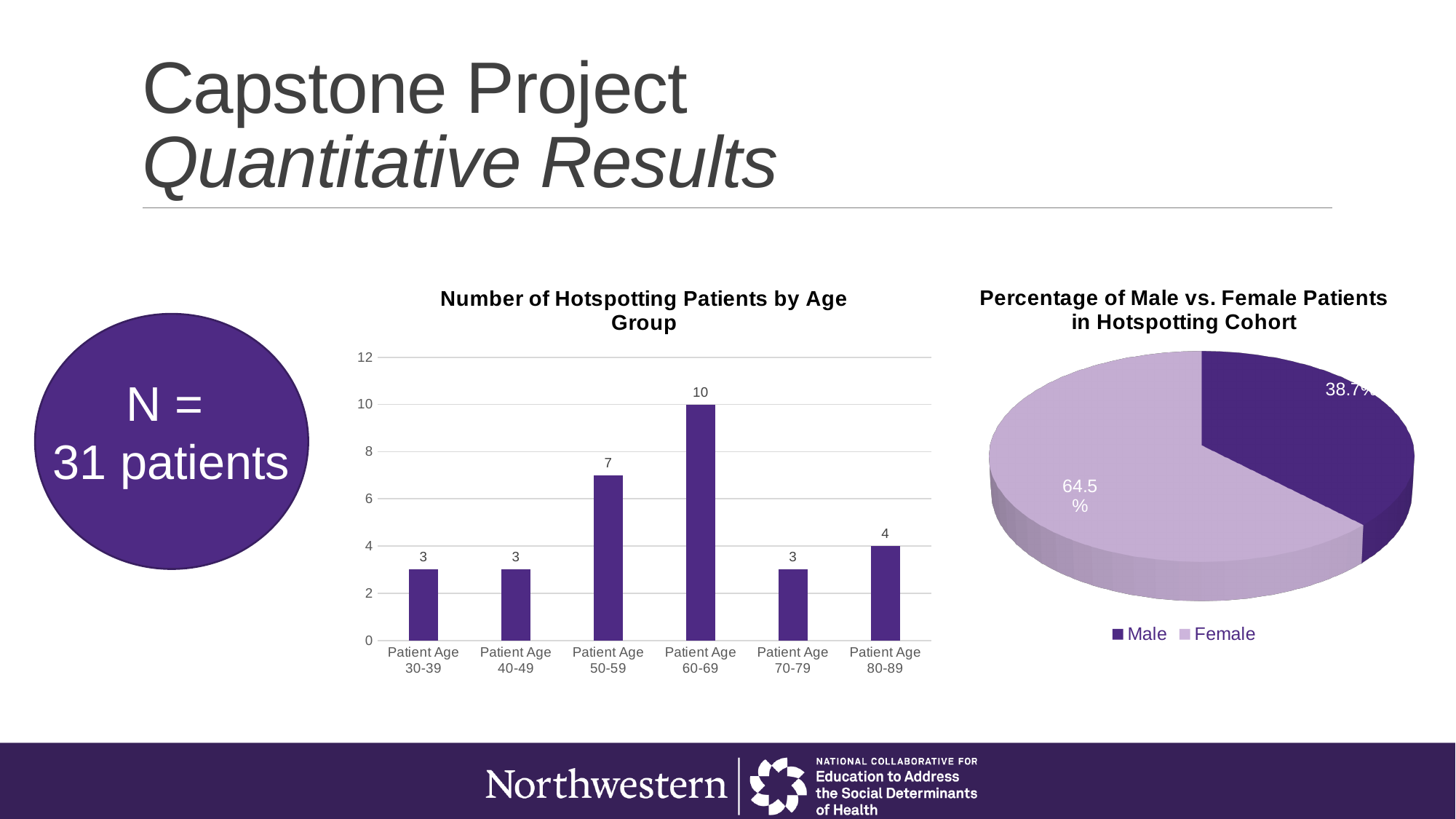
In the 'Percentage of Male vs. Female Patients in Hotspotting Cohort' chart, what share of patients are Female? 64.5% In the 'Number of Hotspotting Patients by Age Group' chart, how many patients are in the Patient Age 60-69 group? 10 In the 'Percentage of Male vs. Female Patients in Hotspotting Cohort' chart, what share of patients are Male? 38.7% What kind of chart is 'Number of Hotspotting Patients by Age Group'? Bar chart In the 'Number of Hotspotting Patients by Age Group' chart, which has more patients: Patient Age 80-89 or Patient Age 70-79? Patient Age 80-89 In the 'Number of Hotspotting Patients by Age Group' chart, how many patients are in the Patient Age 80-89 group? 4 In the 'Number of Hotspotting Patients by Age Group' chart, how many age groups are shown? 6 How many entries does the legend of the 'Percentage of Male vs. Female Patients in Hotspotting Cohort' chart list? 2 What kind of chart is 'Percentage of Male vs. Female Patients in Hotspotting Cohort'? Pie chart In the 'Number of Hotspotting Patients by Age Group' chart, which age group has the highest number of patients? Patient Age 60-69 In the 'Number of Hotspotting Patients by Age Group' chart, what is the difference between the Patient Age 60-69 and Patient Age 50-59 groups? 3 In the 'Number of Hotspotting Patients by Age Group' chart, how many patients are in the Patient Age 50-59 group? 7